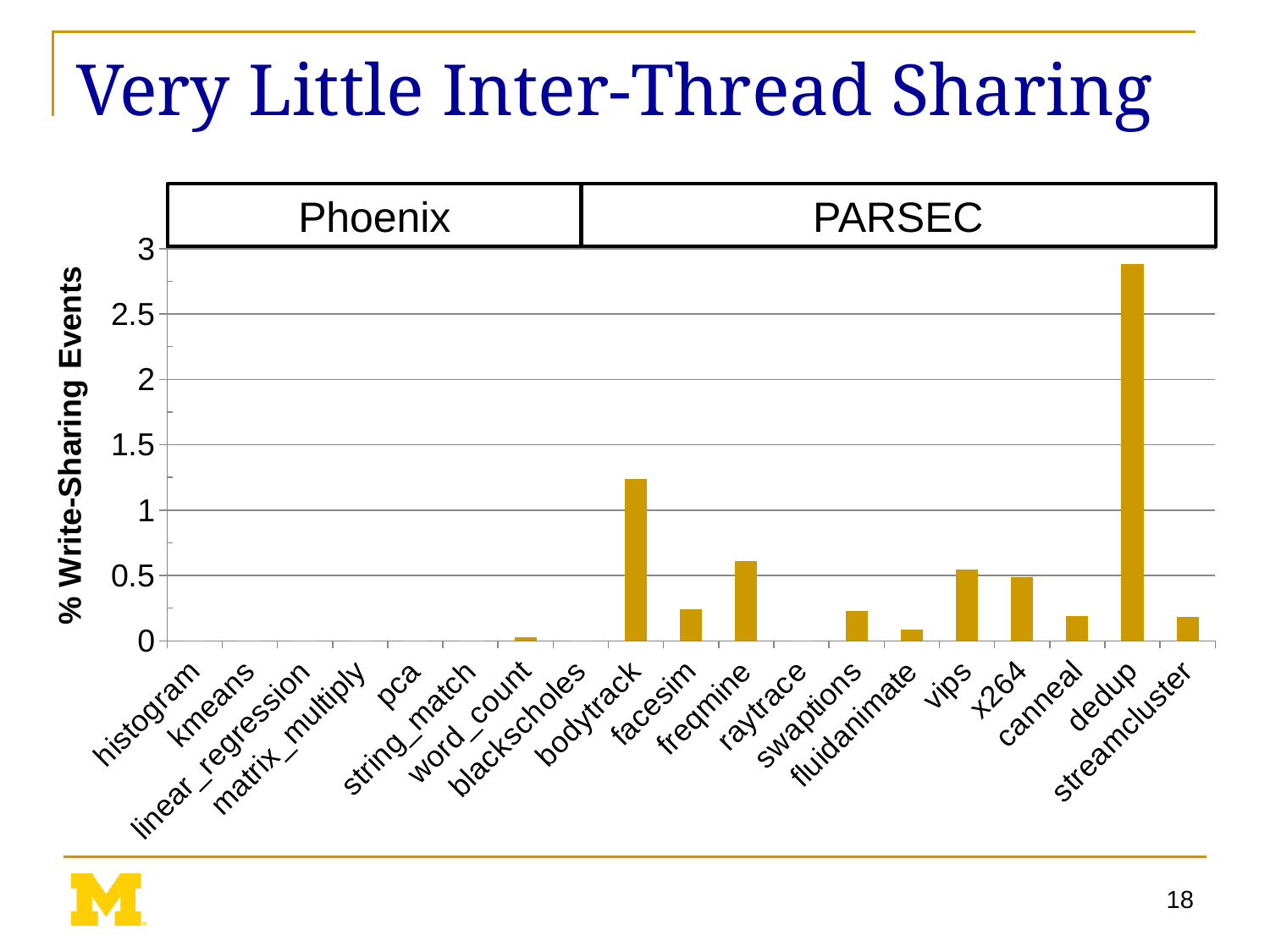
What kind of chart is shown on the slide? bar chart Is the value for fluidanimate greater or less than 0.5? less Which benchmark has the highest % Write-Sharing Events? dedup Which has a higher % Write-Sharing Events, bodytrack or freqmine? bodytrack What is the label of the y axis? % Write-Sharing Events How many benchmark categories are plotted along the x axis? 19 Is the value for facesim greater or less than 0.5? less Is the value for dedup greater or less than 2.5? greater What are the two benchmark suite groups labelled above the chart? Phoenix and PARSEC Which has a higher % Write-Sharing Events, facesim or vips? vips